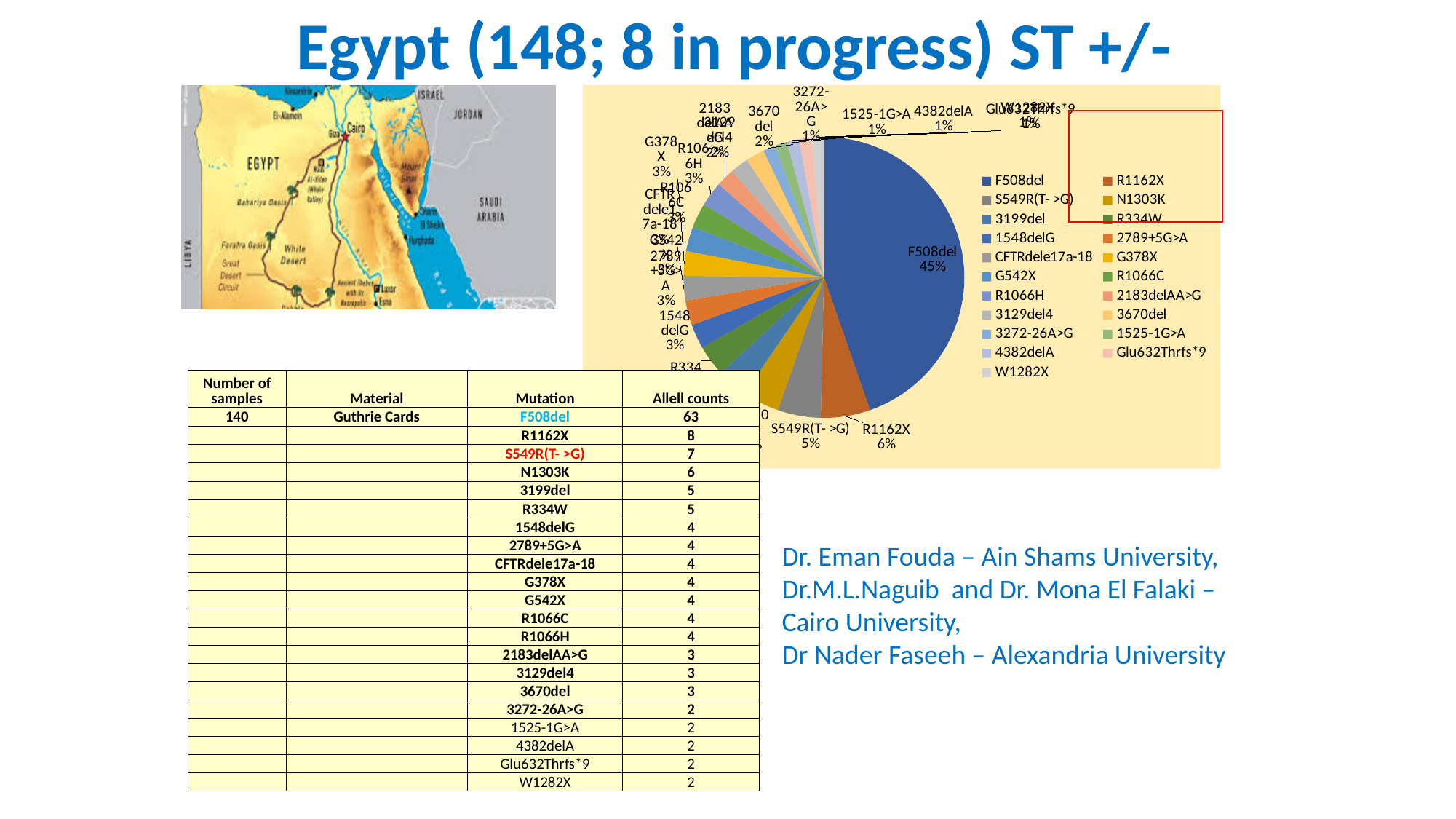
What percentage is shown for S549R(T- >G) in the pie chart? 5% What colour is the F508del slice in the pie chart? dark blue What percentage is shown for 3670del in the pie chart? 2% What is the difference in percentage points between the F508del slice and the R1162X slice? 39 What percentage is shown for R1162X in the pie chart? 6% Which mutation has the largest slice in the pie chart? F508del What percentage is shown for 1525-1G>A in the pie chart? 1% What kind of chart is shown on the slide? pie chart What percentage is shown for 4382delA in the pie chart? 1% What share of the pie does F508del account for? 45% Which has the larger share in the pie chart, R1162X or S549R(T- >G)? R1162X How many mutations are listed in the pie chart's legend? 21